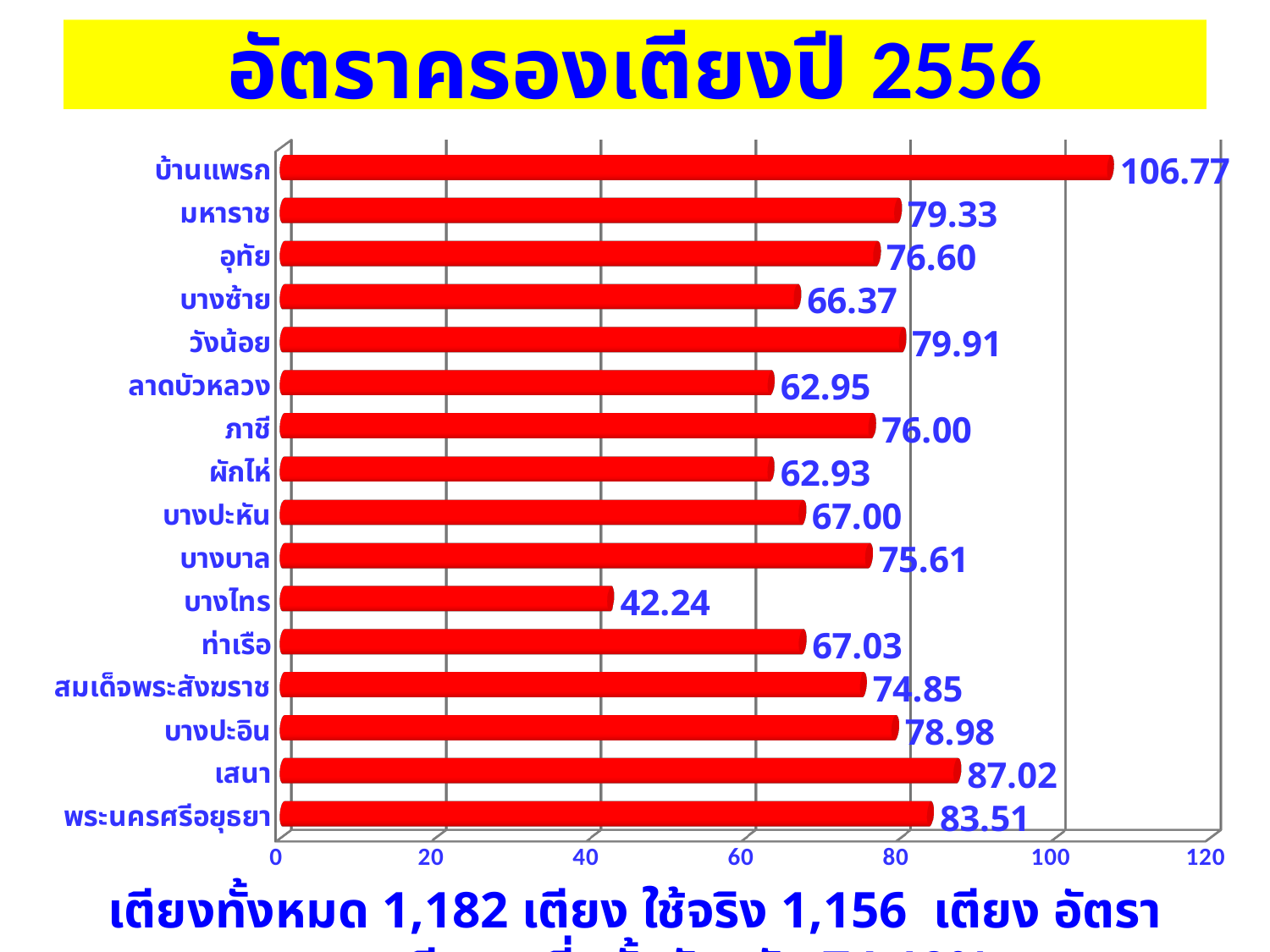
Is the value for มหาราช greater or less than 80? less What is the value for บ้านแพรก? 106.77 Which category has the lowest value? บางไทร What is the value for พระนครศรีอยุธยา? 83.51 What is the value for บางไทร? 42.24 What is the difference between the values for บ้านแพรก and บางไทร? 64.53 What is the value for เสนา? 87.02 Which is larger, the value for วังน้อย or the value for บางซ้าย? วังน้อย What kind of chart is shown on the slide? bar chart Which category has the highest value? บ้านแพรก What is the difference between the values for เสนา and พระนครศรีอยุธยา? 3.51 How many categories are shown in the chart? 16